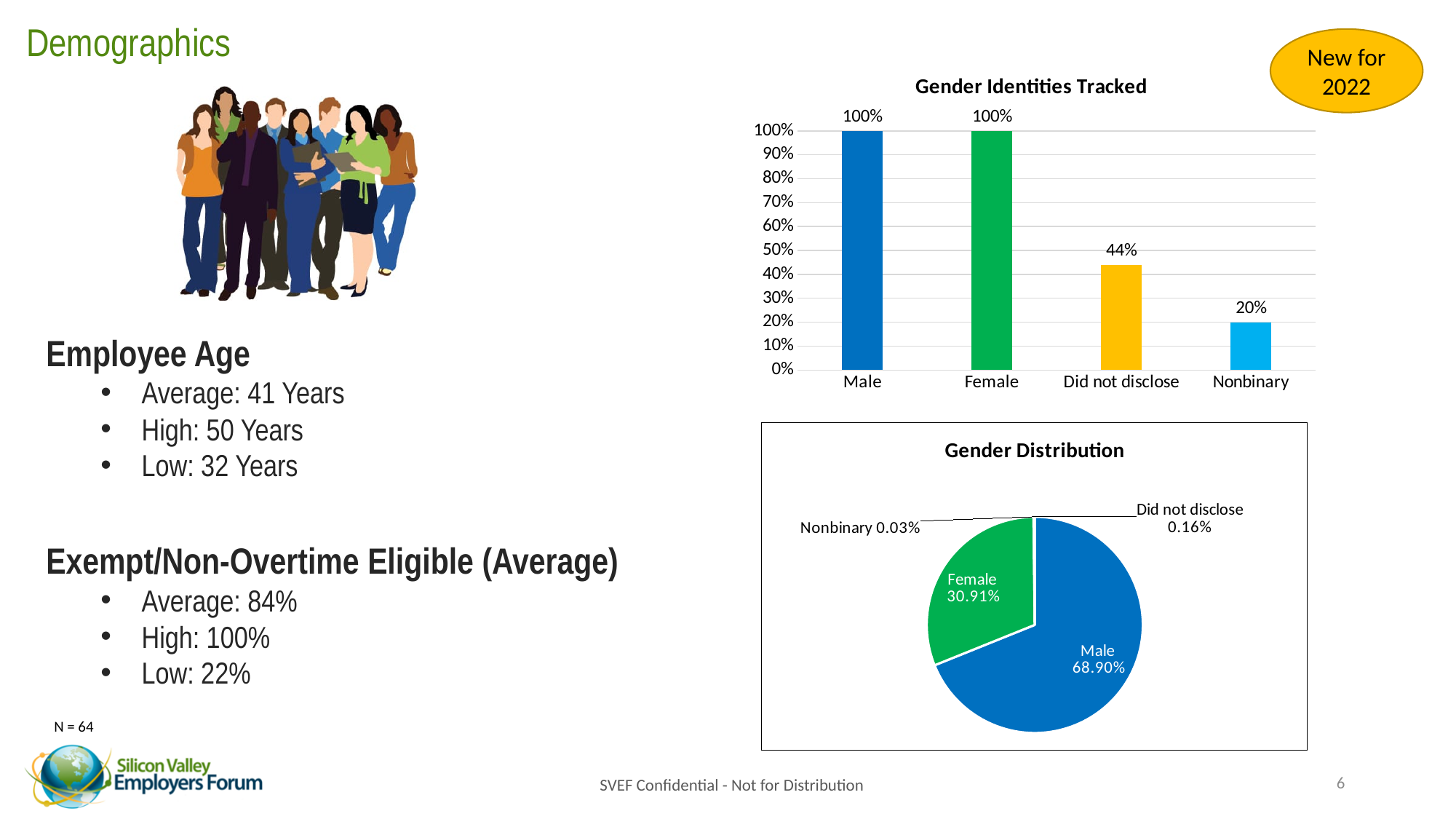
What kind of chart is 'Gender Distribution'? Pie chart In the 'Gender Identities Tracked' chart, what is the difference between the values for Did not disclose and Nonbinary? 24% In the 'Gender Distribution' chart, what is the value for Did not disclose? 0.16% In the 'Gender Distribution' chart, which slice is the largest? Male In the 'Gender Identities Tracked' chart, what is the value for Nonbinary? 20% In the 'Gender Identities Tracked' chart, what is the value for Did not disclose? 44% In the 'Gender Identities Tracked' chart, how many categories are shown on the x axis? 4 In the 'Gender Identities Tracked' chart, which category has the lowest value? Nonbinary In the 'Gender Distribution' chart, which is larger, Nonbinary or Did not disclose? Did not disclose What kind of chart is 'Gender Identities Tracked'? Bar chart In the 'Gender Distribution' chart, what share of the pie is Female? 30.91% In the 'Gender Identities Tracked' chart, is the value for Did not disclose greater or less than 50%? less